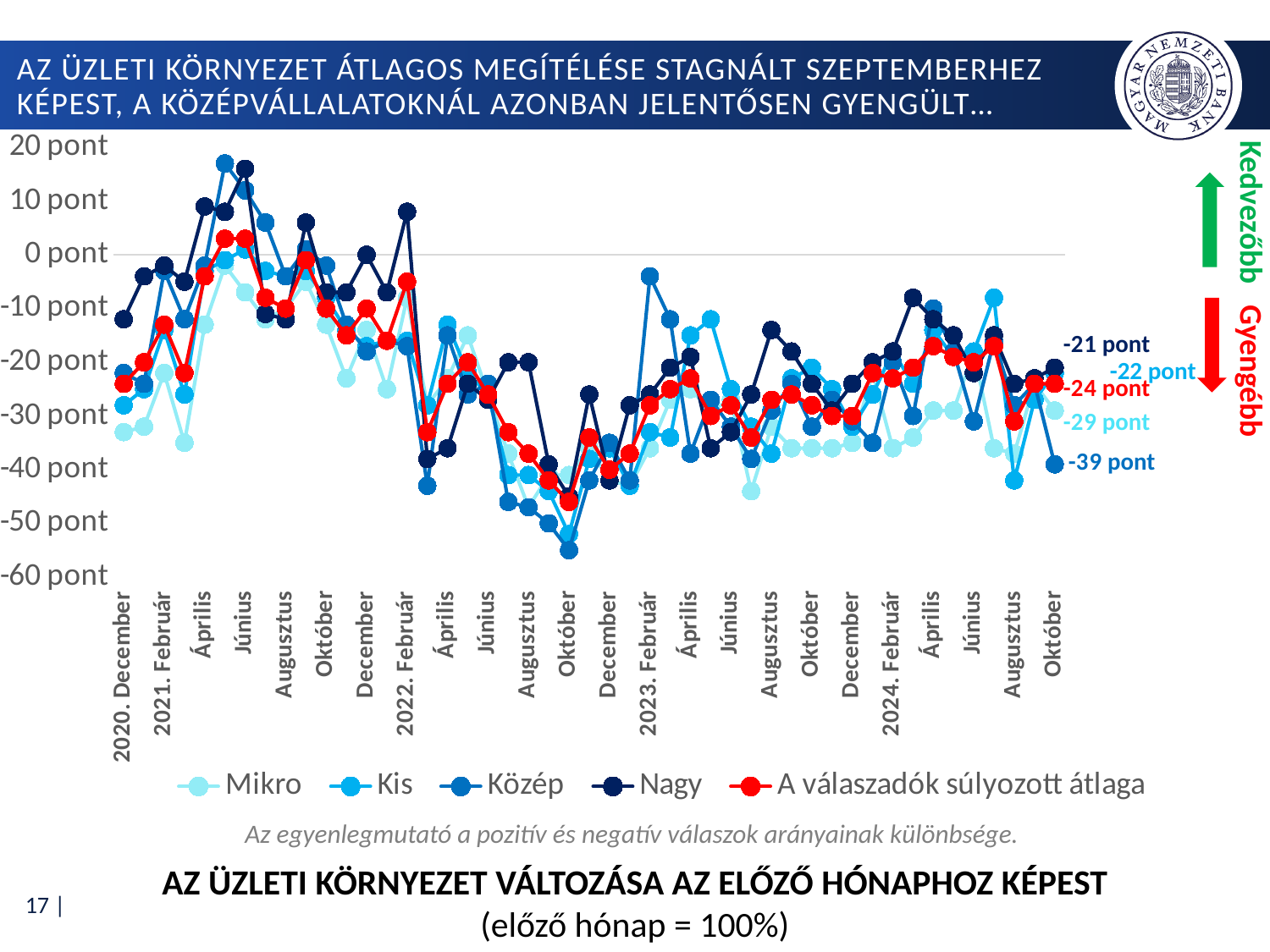
Which series has the lowest labelled value at the end of the chart (October 2024)? Közép What kind of chart is shown on the slide? line chart What is the latest value labelled for the Kis series? -22 pont What is the difference between the end-of-chart labelled values of Nagy (-21 pont) and Közép (-39 pont)? 18 pont At the end of the chart, which is larger: the Mikro value or the Közép value? Mikro What is the latest value labelled for 'A válaszadók súlyozott átlaga'? -24 pont Is the value of 'A válaszadók súlyozott átlaga' in October 2022 greater or less than -40 pont? less How many series does the legend list? 5 What is the latest (October 2024) value labelled for the Nagy series? -21 pont What is the latest value labelled for the Közép series? -39 pont Which series has the highest labelled value at the end of the chart (October 2024)? Nagy What is the latest value labelled for the Mikro series? -29 pont